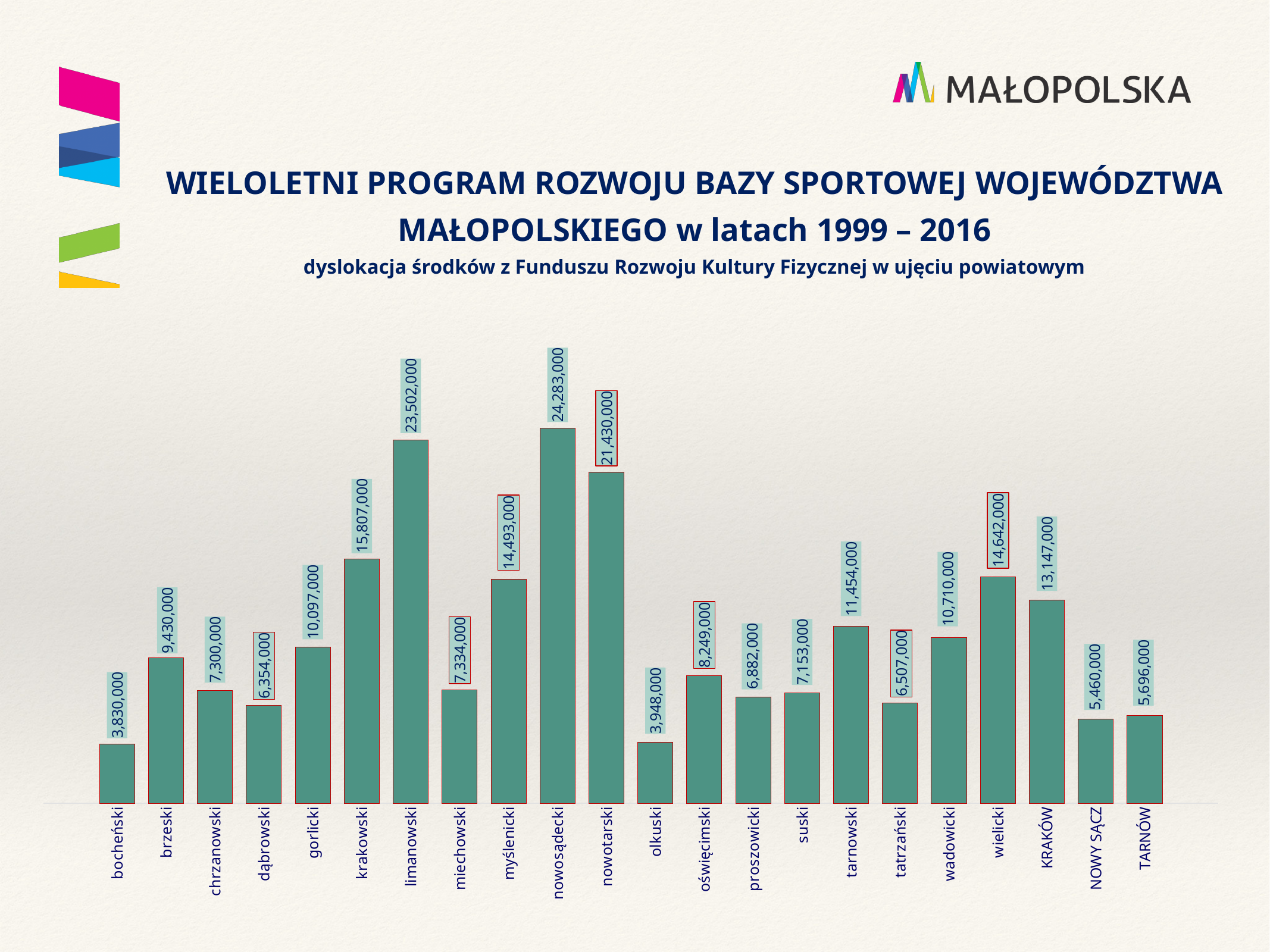
How many categories are shown on the x axis? 22 Which is larger, the value for tarnowski or the value for wadowicki? tarnowski What is the value for limanowski? 23,502,000 What is the value for wadowicki? 10,710,000 Which category has the lowest value? bocheński What is the value for tatrzański? 6,507,000 What is the difference between the values for KRAKÓW and TARNÓW? 7,451,000 Which category has the highest value? nowosądecki What kind of chart is shown on the slide? bar chart Which is larger, the value for brzeski or the value for chrzanowski? brzeski What is the difference between the values for nowosądecki and limanowski? 781,000 What is the value for KRAKÓW? 13,147,000